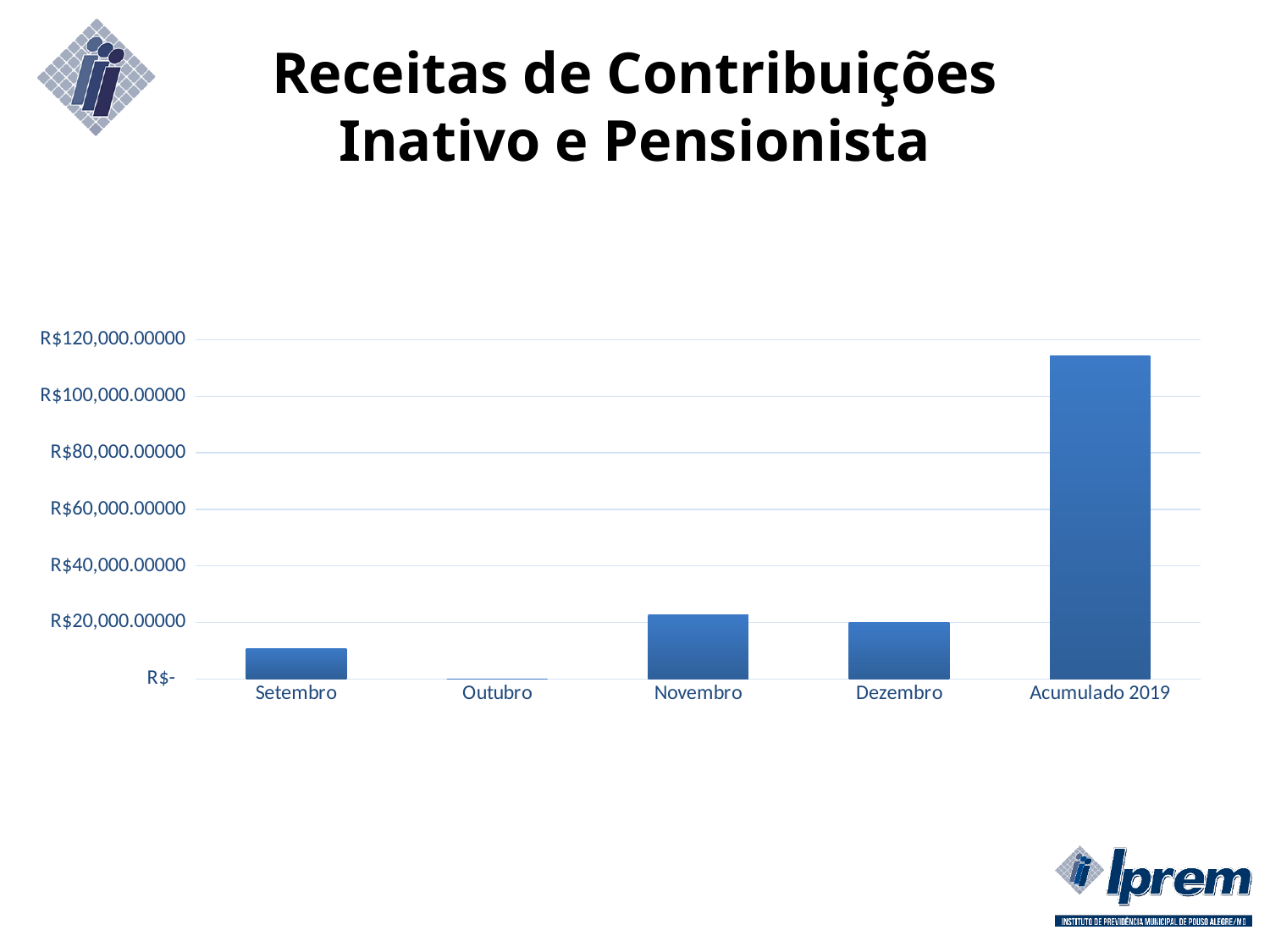
How many categories are shown on the x axis of the chart? 5 Is the value for Setembro greater or less than R$20,000.00000? less Which is larger, the value for Dezembro or the value for Outubro? Dezembro Is the value for Acumulado 2019 greater or less than R$120,000.00000? less Which is larger, the value for Novembro or the value for Setembro? Novembro Which category has the lowest value in the chart? Outubro Which category has the highest value in the chart? Acumulado 2019 What is the title of the slide containing the chart? Receitas de Contribuições Inativo e Pensionista What kind of chart is shown on the slide? bar chart Is the value for Novembro greater or less than R$20,000.00000? greater Which month among Setembro, Outubro, Novembro and Dezembro has the highest value? Novembro